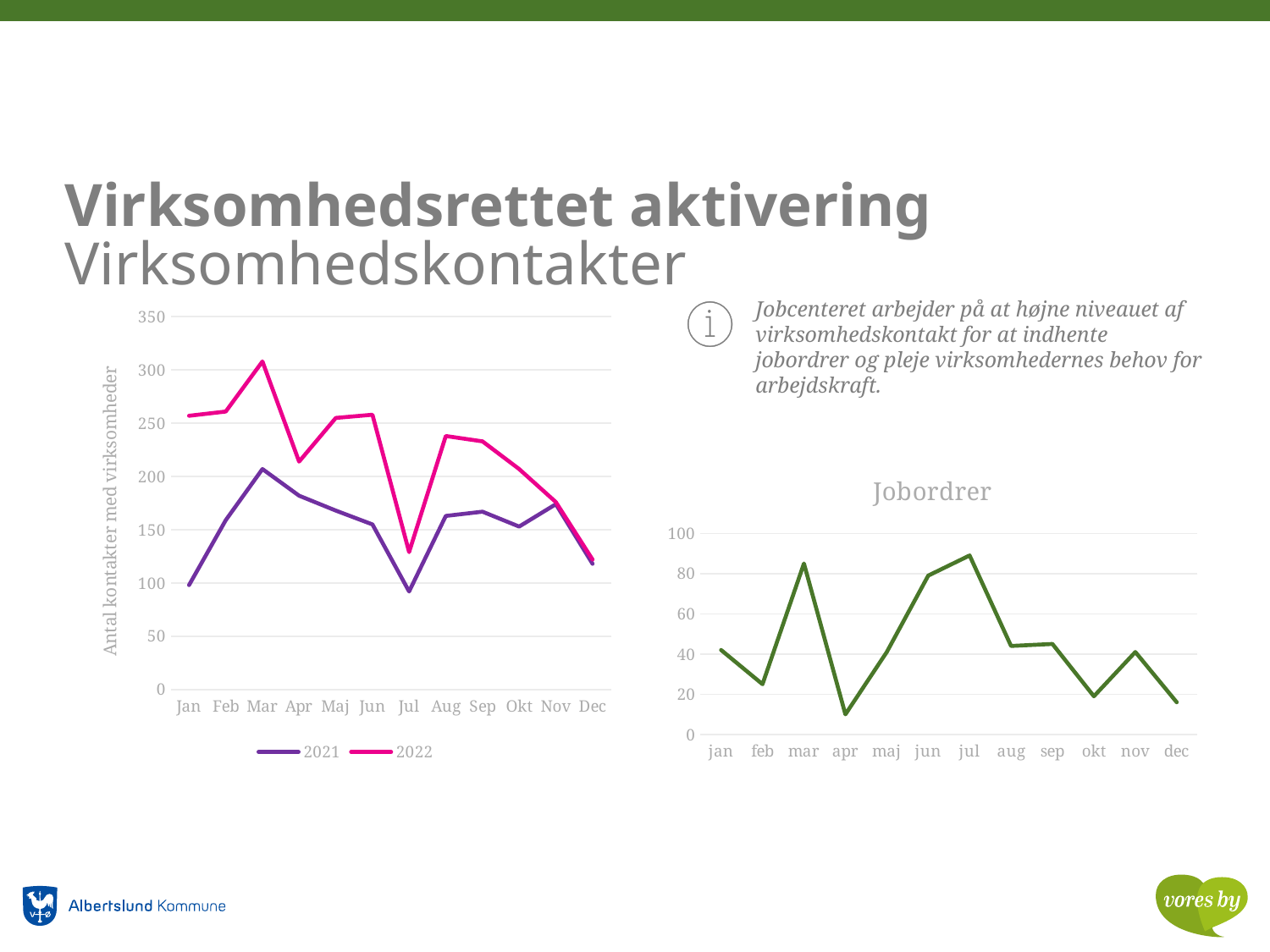
On the left chart (Antal kontakter med virksomheder), which month has the highest value for the 2022 series? Mar On the left chart (Antal kontakter med virksomheder), how many months are shown on the x axis? 12 On the left chart (Antal kontakter med virksomheder), is the 2021 value for Jan greater or less than 150? less On the left chart (Antal kontakter med virksomheder), is the 2022 value for Mar greater or less than 300? greater On the left chart (Antal kontakter med virksomheder), which month has the highest value for the 2021 series? Mar On the left chart (Antal kontakter med virksomheder), is the 2021 value for Jul greater or less than 100? less What kind of chart is the Jobordrer chart? line chart On the Jobordrer chart, which month has the lowest value? apr On the left chart (Antal kontakter med virksomheder), how many series does the legend list? 2 On the left chart (Antal kontakter med virksomheder), which series has the larger value in Mar, 2021 or 2022? 2022